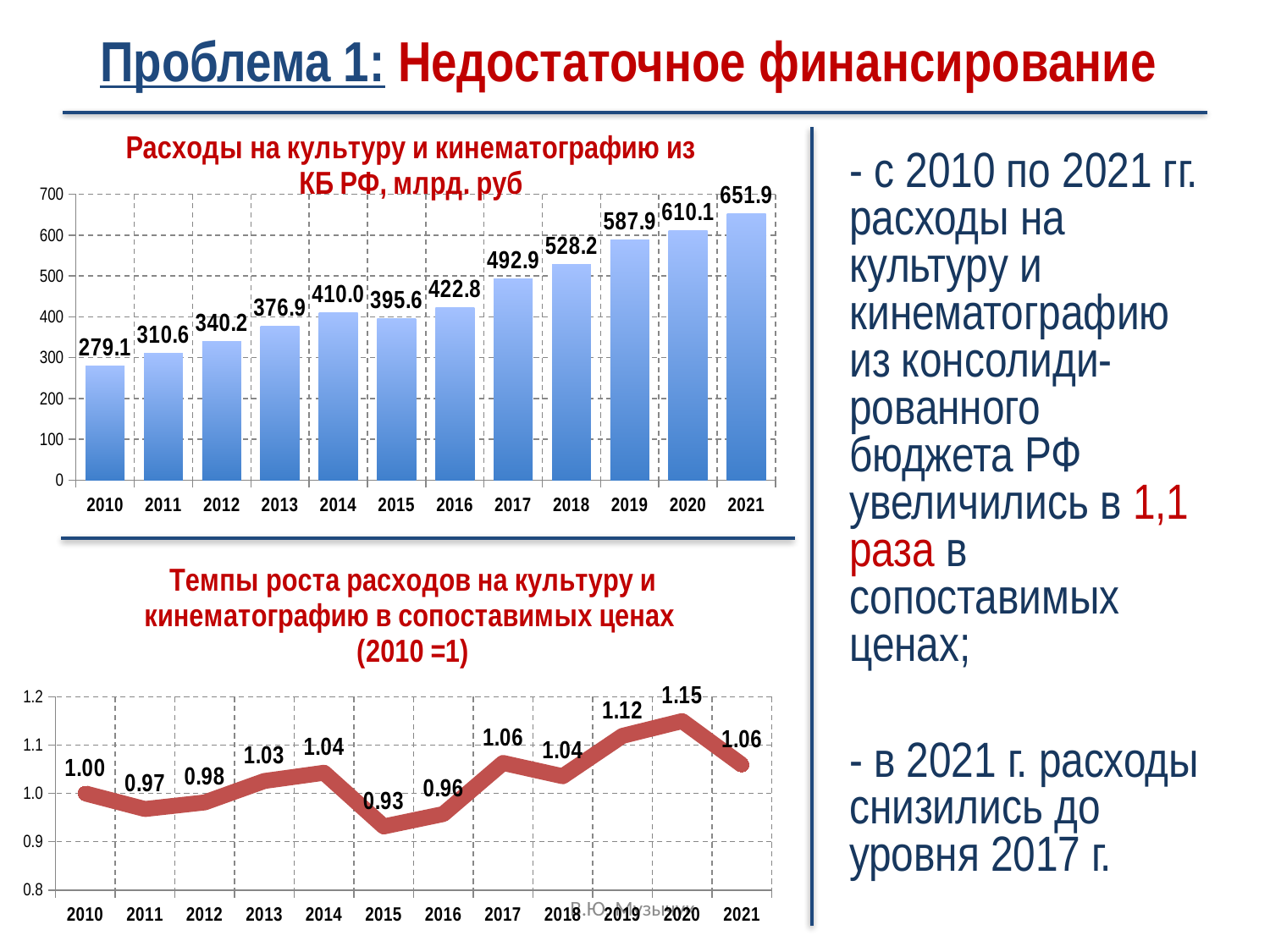
What kind of chart is the bottom chart (Темпы роста расходов на культуру и кинематографию в сопоставимых ценах)? line chart In the bottom chart (Темпы роста расходов на культуру и кинематографию в сопоставимых ценах), which year has the lowest value? 2015 In the bottom chart (Темпы роста расходов на культуру и кинематографию в сопоставимых ценах), which year has the highest value? 2020 What kind of chart is the top chart (Расходы на культуру и кинематографию из КБ РФ, млрд. руб)? bar chart In the top chart (Расходы на культуру и кинематографию из КБ РФ, млрд. руб), what is the value for 2017? 492.9 In the top chart (Расходы на культуру и кинематографию из КБ РФ, млрд. руб), what is the difference between the values for 2021 and 2010? 372.8 In the bottom chart (Темпы роста расходов на культуру и кинематографию в сопоставимых ценах), what is the value for 2015? 0.93 In the top chart (Расходы на культуру и кинематографию из КБ РФ, млрд. руб), which year has the lowest value? 2010 In the top chart (Расходы на культуру и кинематографию из КБ РФ, млрд. руб), which year has the highest value? 2021 In the bottom chart (Темпы роста расходов на культуру и кинематографию в сопоставимых ценах), what is the difference between the values for 2020 and 2021? 0.09 In the top chart (Расходы на культуру и кинематографию из КБ РФ, млрд. руб), how many years are shown on the x axis? 12 In the top chart (Расходы на культуру и кинематографию из КБ РФ, млрд. руб), which is larger: the value for 2014 or the value for 2015? 2014